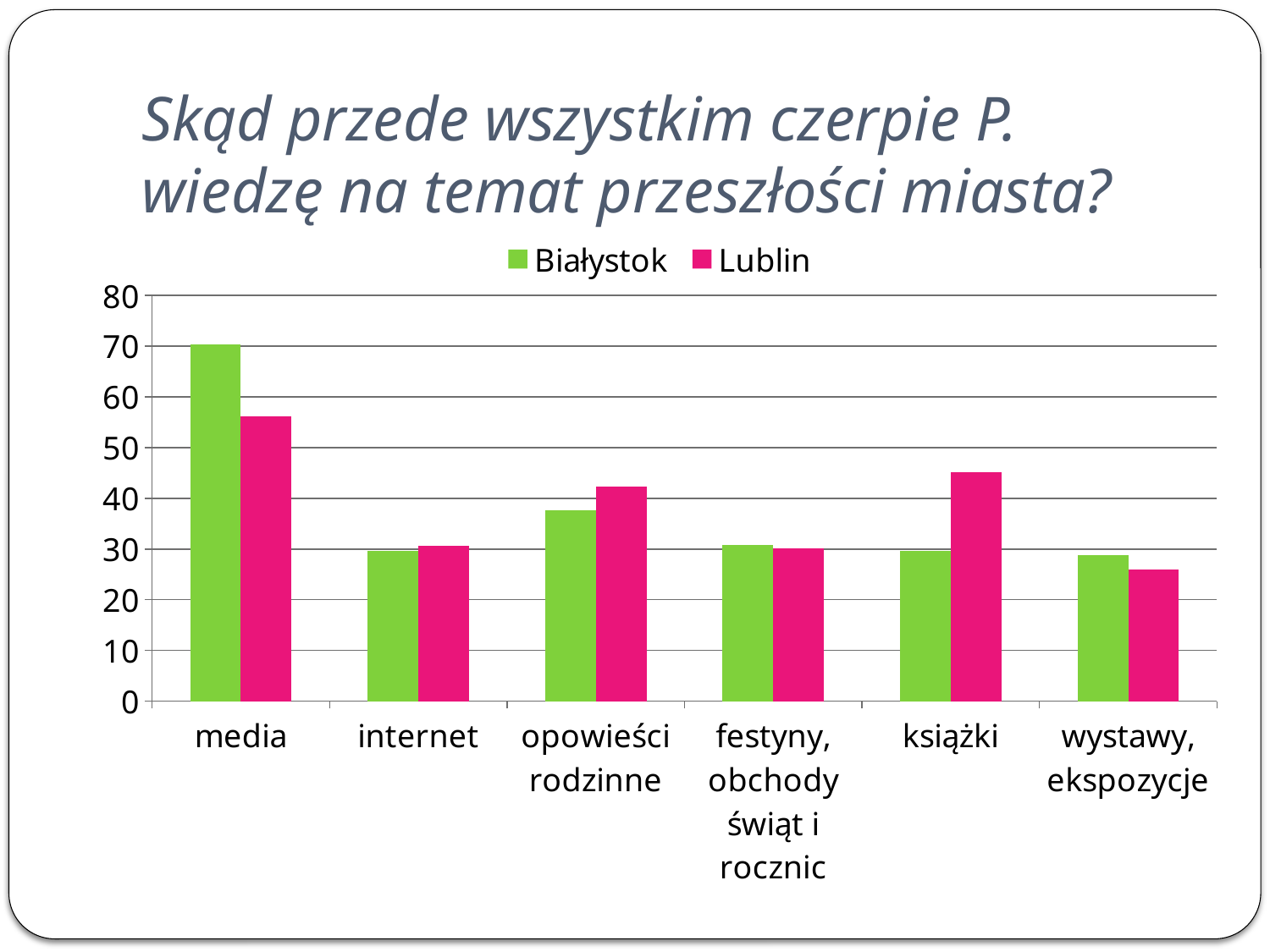
Which category has the lowest value for Lublin? wystawy, ekspozycje Is the value for Lublin in the książki category greater or less than 40? greater For media, which series has the larger value, Białystok or Lublin? Białystok For książki, which series has the larger value, Białystok or Lublin? Lublin How many series does the legend list? 2 Is the value for Białystok in the media category greater or less than 60? greater What kind of chart is shown on the slide? bar chart Which series is shown in green in the legend? Białystok Which category has the highest value for Lublin? media Which category has the highest value for Białystok? media Is the value for Lublin in the wystawy, ekspozycje category greater or less than 30? less How many categories are shown on the x axis? 6